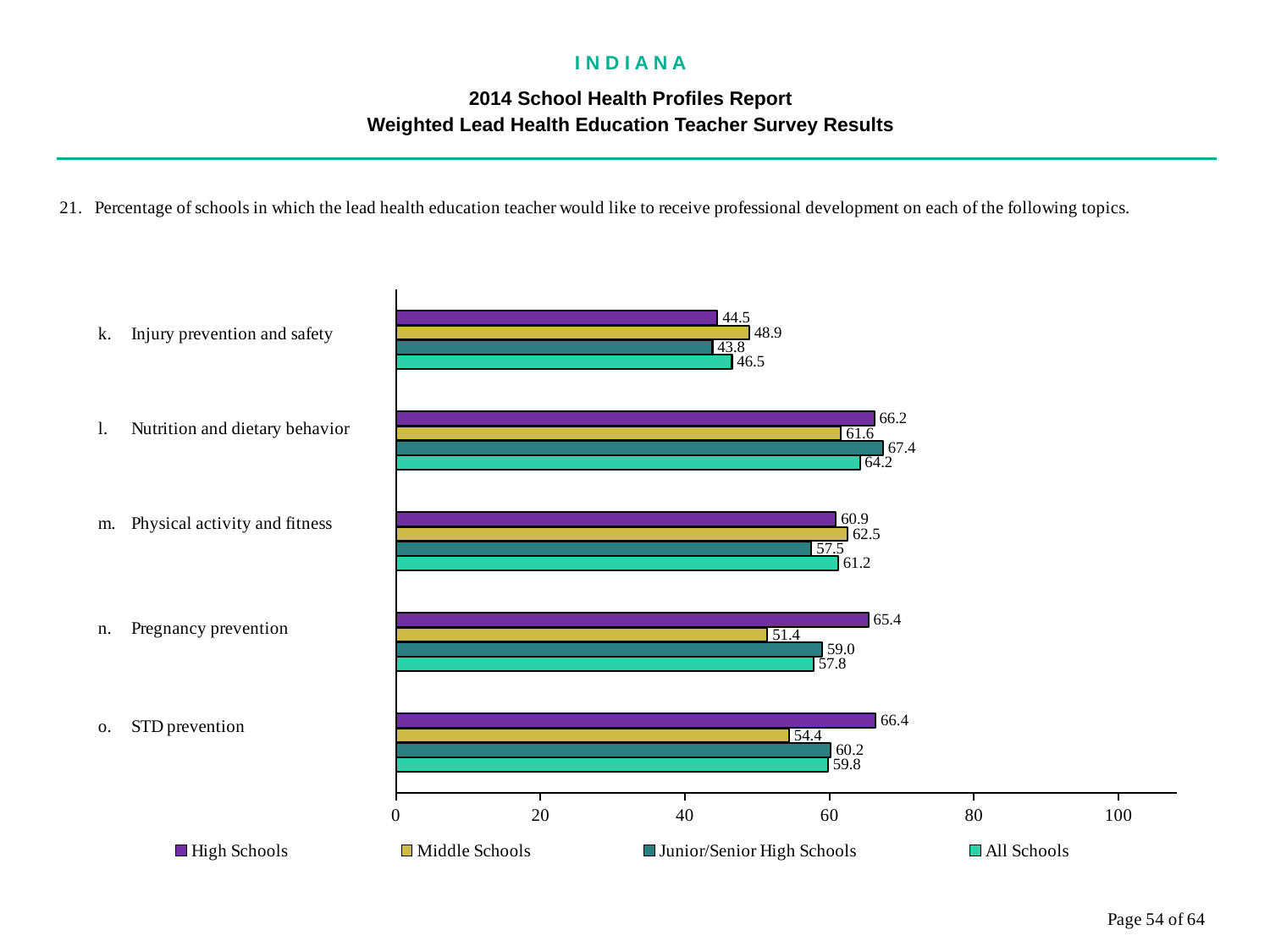
What is the value for All Schools for STD prevention? 59.8 Which topic has the lowest value for All Schools? Injury prevention and safety What is the value for Middle Schools for Pregnancy prevention? 51.4 What is the difference between the High Schools and Middle Schools values for STD prevention? 12.0 Which topic has the highest value for Middle Schools? Physical activity and fitness Which series is shown in purple in the legend? High Schools How many topics are shown on the chart? 5 How many series does the legend list? 4 What is the value for High Schools for Injury prevention and safety? 44.5 What is the value for Junior/Senior High Schools for Nutrition and dietary behavior? 67.4 What kind of chart is shown on the slide? Bar chart For Pregnancy prevention, which is larger: the High Schools value or the Junior/Senior High Schools value? High Schools